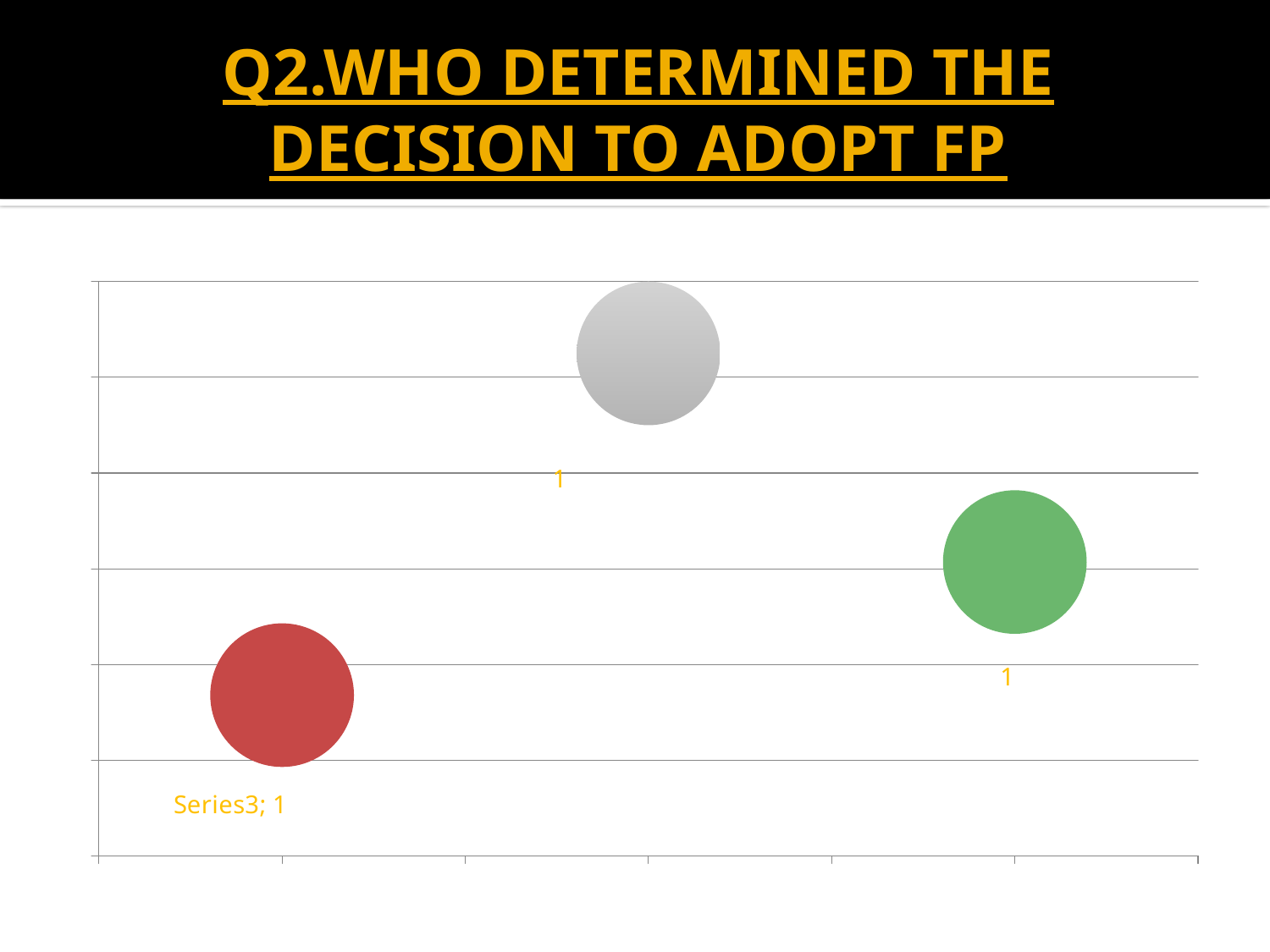
What value is shown in the data label for Series3? 1 Which bubble is plotted highest on the chart? the gray bubble What value is shown in the data label next to the gray bubble? 1 Which bubble is plotted lowest on the chart? the red bubble What value is shown in the data label next to the green bubble? 1 How many bubbles are plotted on the chart? 3 Is the green bubble plotted higher or lower than the red bubble? higher What colour is the bubble labelled Series3? red What is the title of the slide containing the chart? Q2.WHO DETERMINED THE DECISION TO ADOPT FP What kind of chart is shown on the slide? bubble chart